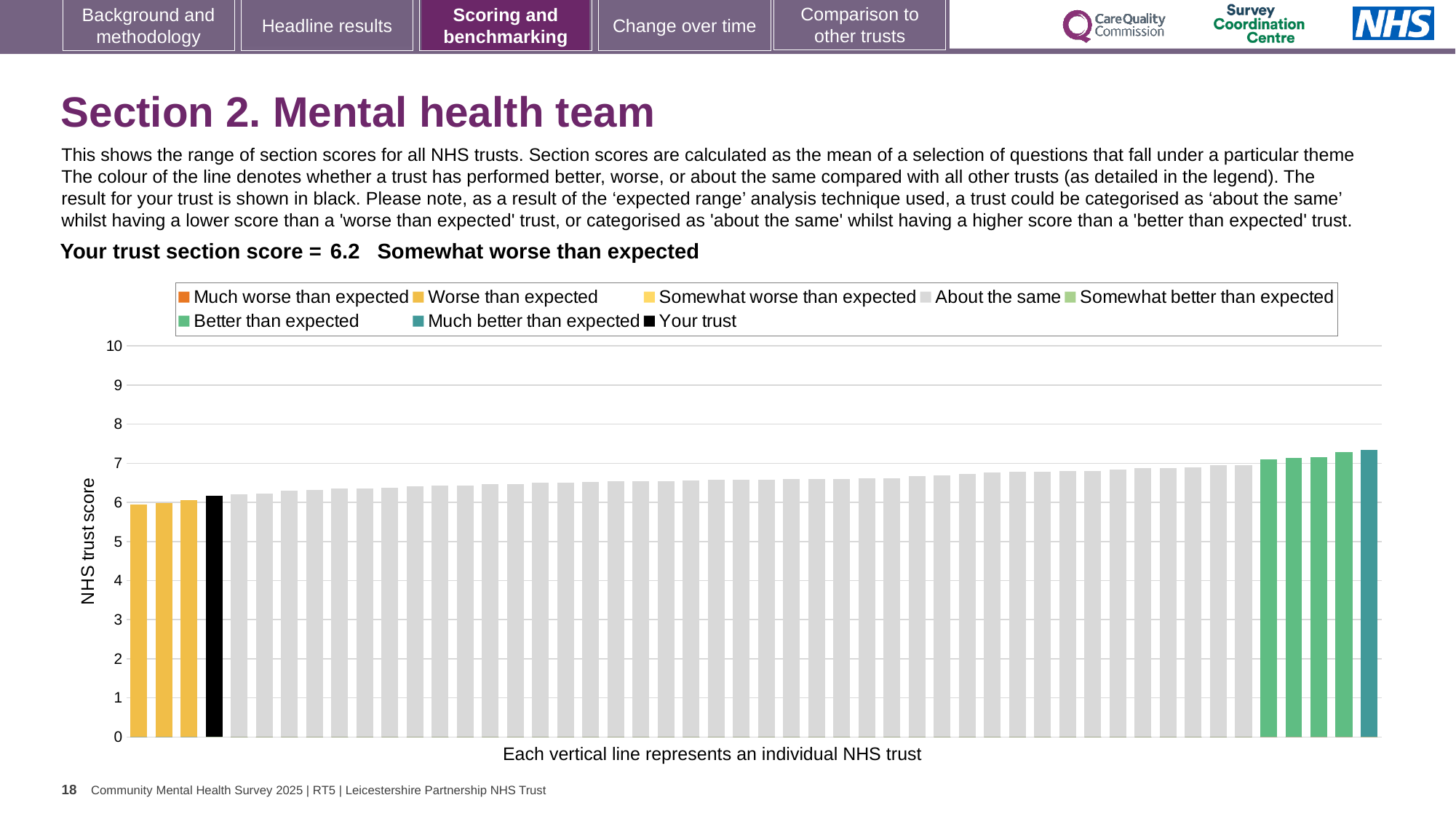
How many entries does the chart legend list? 8 What is the section score for your trust shown on the slide? 6.2 How many bars are coloured yellow (worse than expected) in the chart? 3 What is the label on the vertical axis of the chart? NHS trust score Is the value for the tallest bar on the right of the chart greater or less than 7? greater How is your trust's section score categorised according to the slide? Somewhat worse than expected Which bar has the highest value in the chart? The rightmost bar Do the bar values rise or fall from left to right across the chart? Rise What does the caption below the chart say each vertical line represents? An individual NHS trust Is the value for your trust (the black bar) greater or less than 7? less Is the value for the lowest bar on the left of the chart greater or less than 5? greater What kind of chart is shown on the slide? Bar chart